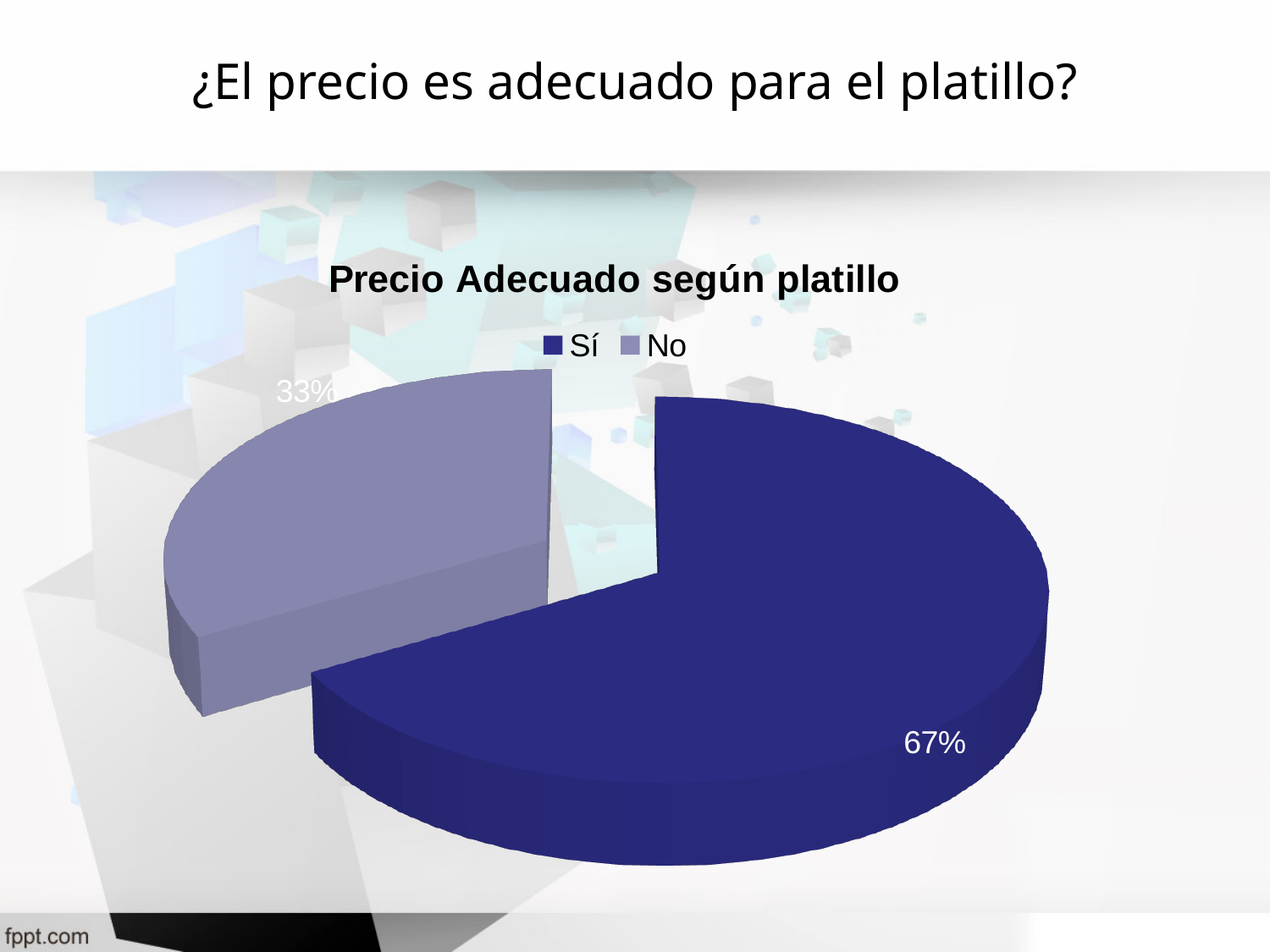
Which category has the largest slice of the pie? Sí How many entries does the legend list? 2 How many categories does the pie chart show? 2 What is the difference in percentage points between the "Sí" and "No" slices? 34 percentage points Which category has the smallest slice of the pie? No Which legend entry is shown in dark blue? Sí What share of the pie does the "No" slice represent? 33% What kind of chart is shown on the slide? Pie chart What is the title of the chart? Precio Adecuado según platillo What share of the pie does the "Sí" slice represent? 67% Which is larger, the "Sí" slice or the "No" slice? Sí